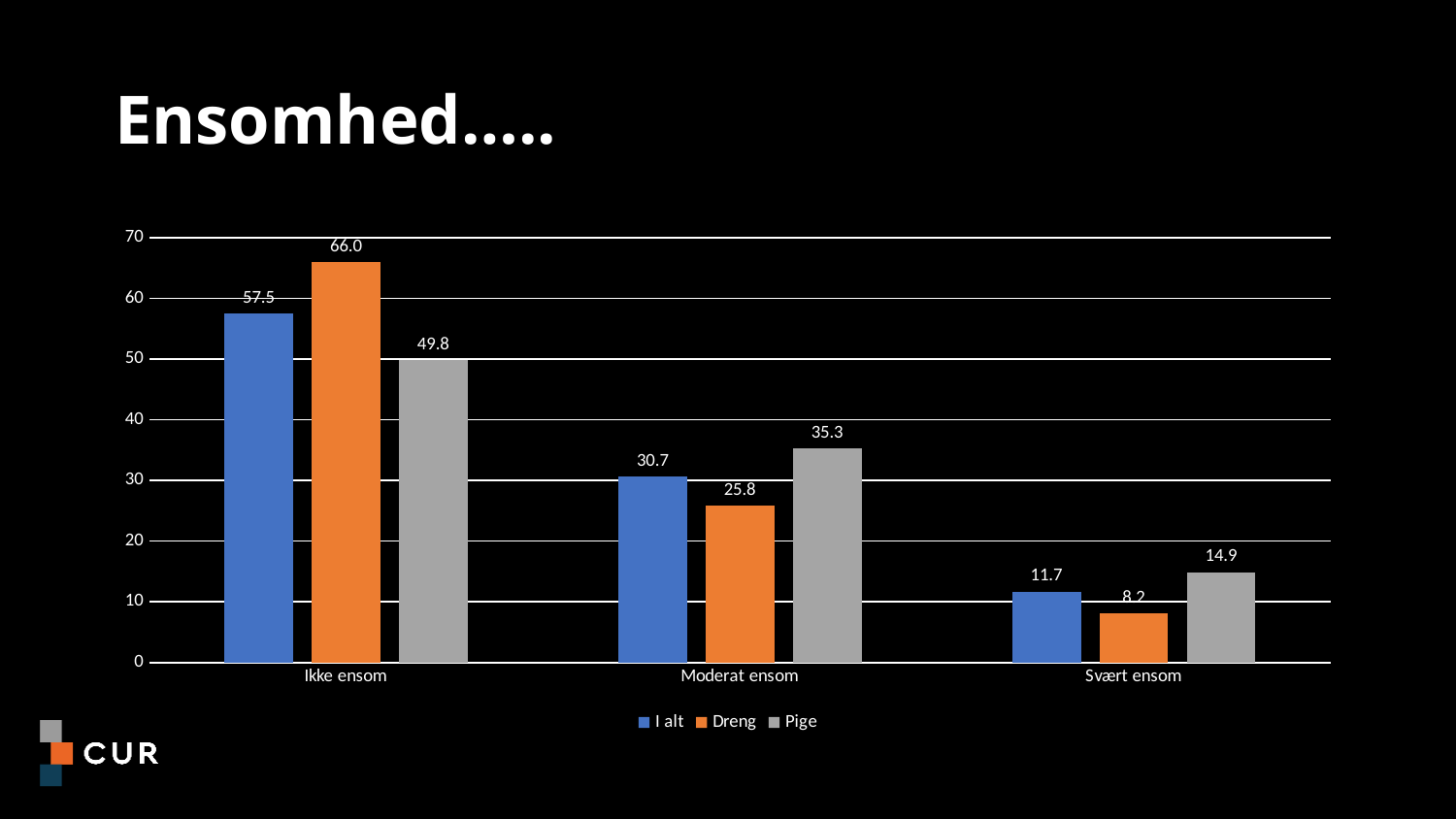
What is the value for Pige in the Moderat ensom category? 35.3 What type of chart is shown on the slide? bar chart How many series does the legend list? 3 Is the value for Dreng in the Svært ensom category greater or less than 10? less What is the difference between the I alt value and the Pige value in the Ikke ensom category? 7.7 Which legend entry is shown in orange? Dreng Which series has the highest value in the Ikke ensom category? Dreng Which is larger in the Moderat ensom category, the I alt value or the Pige value? Pige What is the value for I alt in the Svært ensom category? 11.7 What is the value for Dreng in the Ikke ensom category? 66.0 Which series has the lowest value in the Moderat ensom category? Dreng How many categories are shown on the x axis? 3